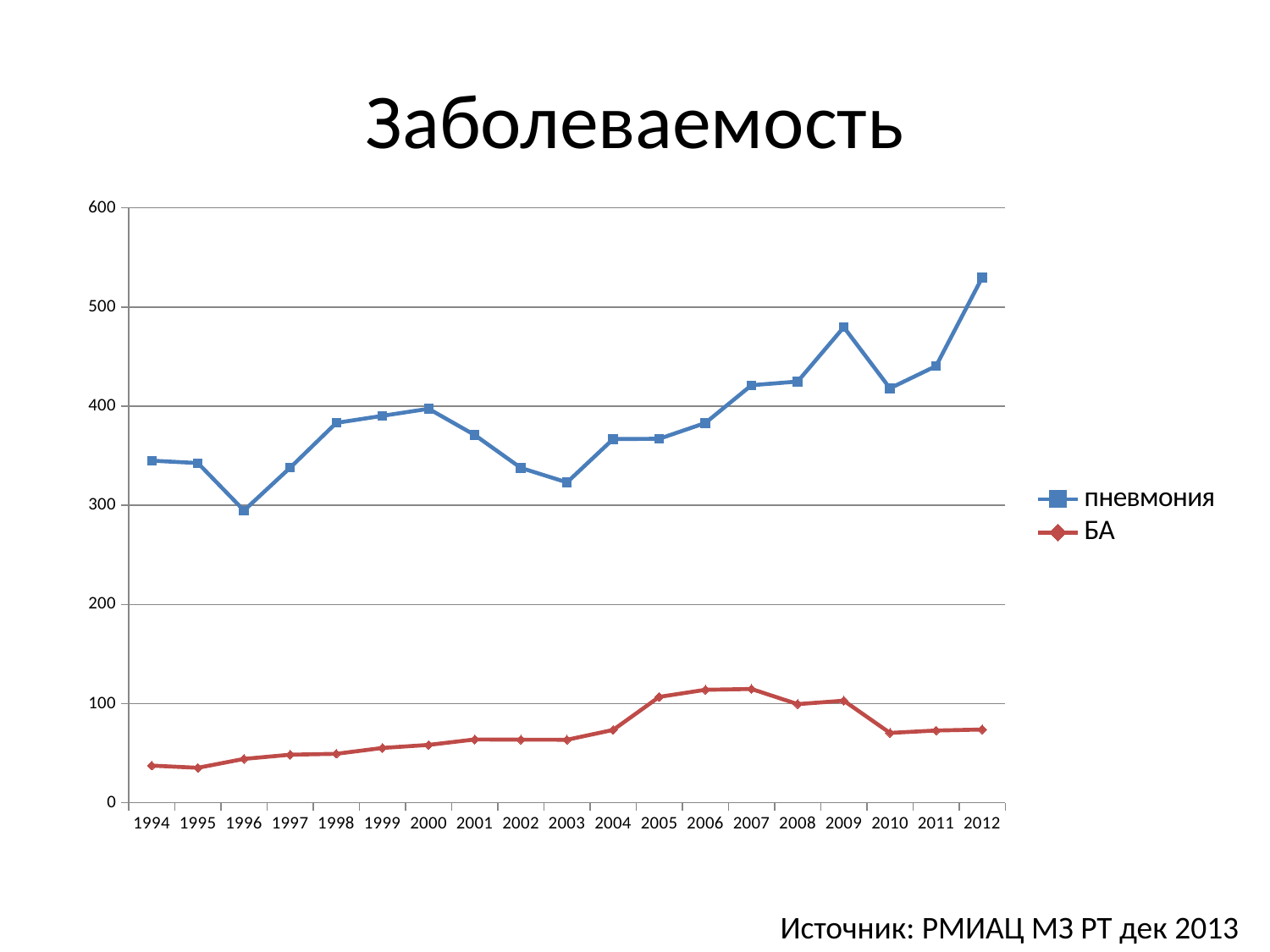
Does the value for пневмония rise or fall from 1996 to 2000? rise In which year is the value for пневмония lowest? 1996 Is the value for БА in 2006 greater or less than 100? greater Which is larger: the value for БА in 2004 or in 2005? 2005 What kind of chart is shown on the slide? line chart In which year is the value for пневмония highest? 2012 How many years are shown on the x axis? 19 How many series does the legend list? 2 Is the value for БА in 2010 greater or less than 100? less Is the value for пневмония in 2012 greater or less than 500? greater Which is larger: the value for пневмония in 2009 or in 2010? 2009 What is the title of the chart? Заболеваемость